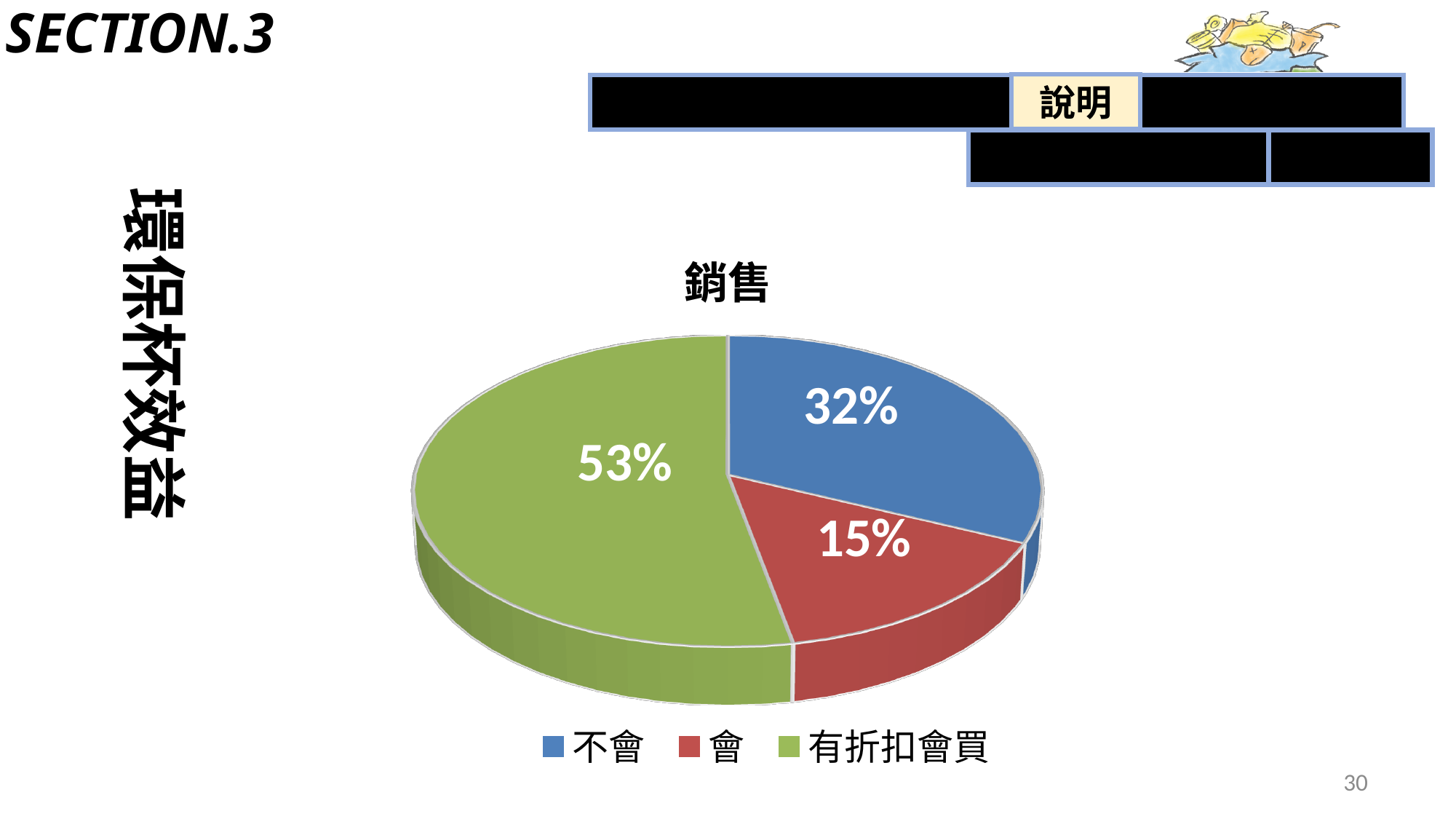
What type of chart is shown on the slide? pie chart What percentage is shown for 有折扣會買? 53% Which category has the smallest share of the pie? 會 Which is larger, the share for 不會 or the share for 會? 不會 What percentage is shown for 不會? 32% What is the difference between the shares of 有折扣會買 and 不會? 21% Which category has the largest share of the pie? 有折扣會買 How many categories does the pie chart have? 3 What is the title of the chart? 銷售 Which colour represents 會 in the legend? red What percentage is shown for 會? 15% What is the difference between the shares of 不會 and 會? 17%